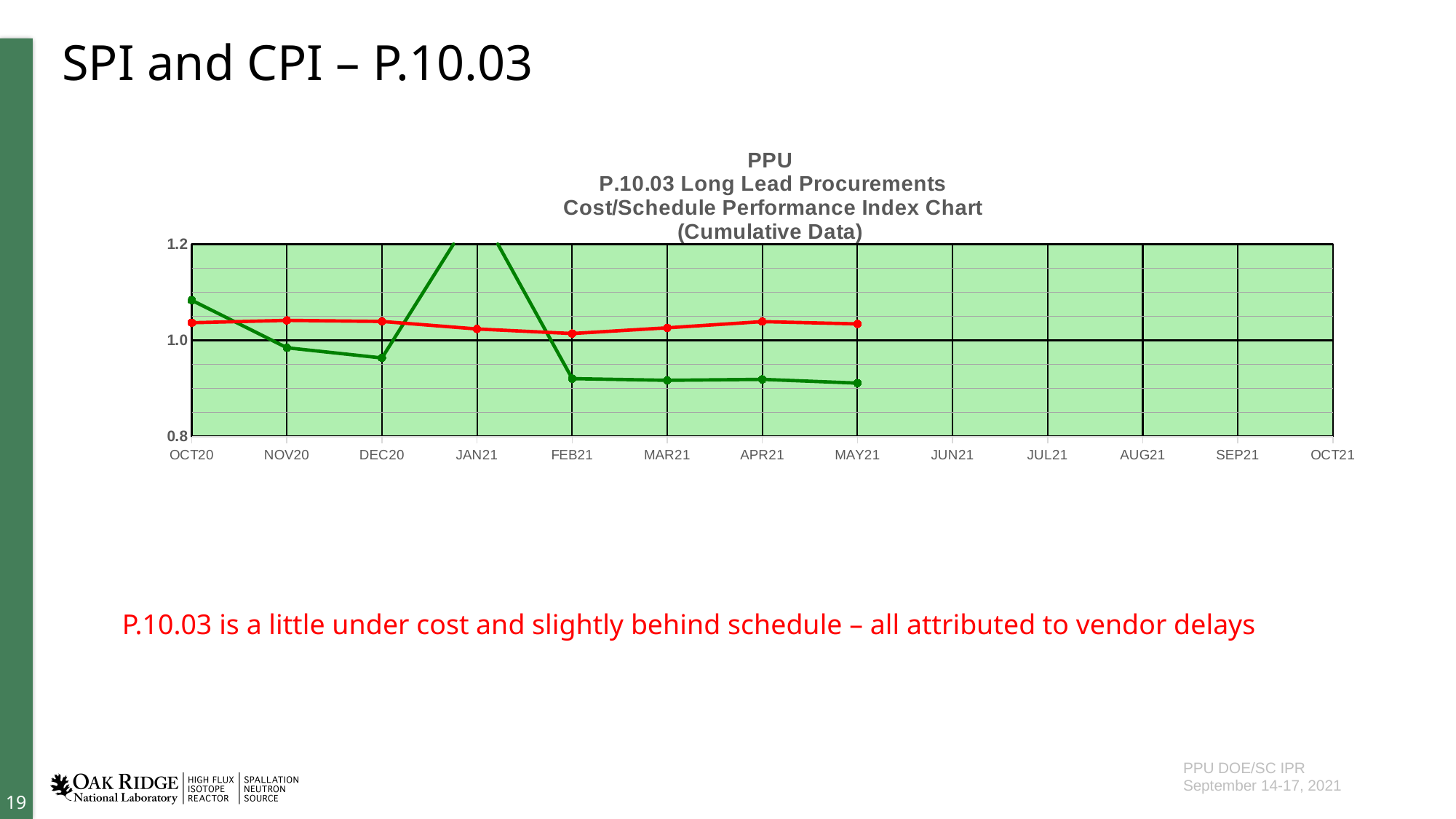
Is the value of the red line at OCT20 greater or less than 1.0? greater At OCT20, which line has the larger value, the red line or the green line? green line Is the value of the green line at FEB21 greater or less than 1.0? less Is the value of the green line at DEC20 greater or less than 1.0? less What is the last month on the x axis for which data points are plotted? MAY21 At MAY21, which line has the larger value, the red line or the green line? red line What kind of chart is shown on the slide? line chart Does the green line rise or fall from OCT20 to DEC20? fall What is the highest value shown on the y axis of the chart? 1.2 How many month labels are shown on the x axis of the chart? 13 How many lines are plotted on the chart? 2